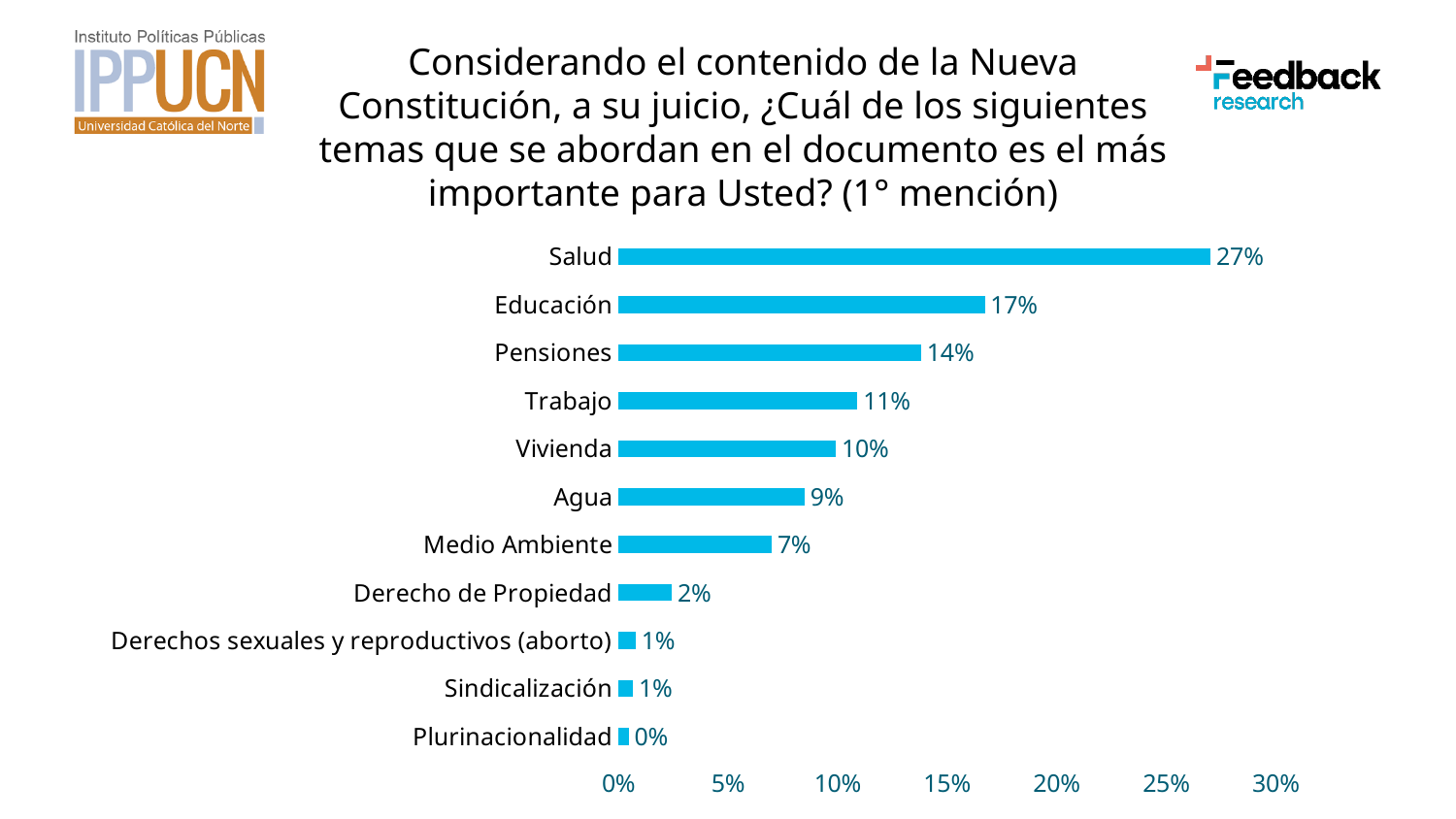
What is the difference between the values for Trabajo and Agua? 2% What is the highest value shown on the horizontal axis? 30% What kind of chart is shown on the slide? Bar chart How many categories are shown in the chart? 11 What is the value for Pensiones? 14% Which category has the highest value? Salud Which category has the lowest value? Plurinacionalidad What is the value for Salud? 27% What is the value for Medio Ambiente? 7% What is the difference between the values for Salud and Educación? 10% Which is larger, the value for Vivienda or the value for Medio Ambiente? Vivienda What is the value for Plurinacionalidad? 0%